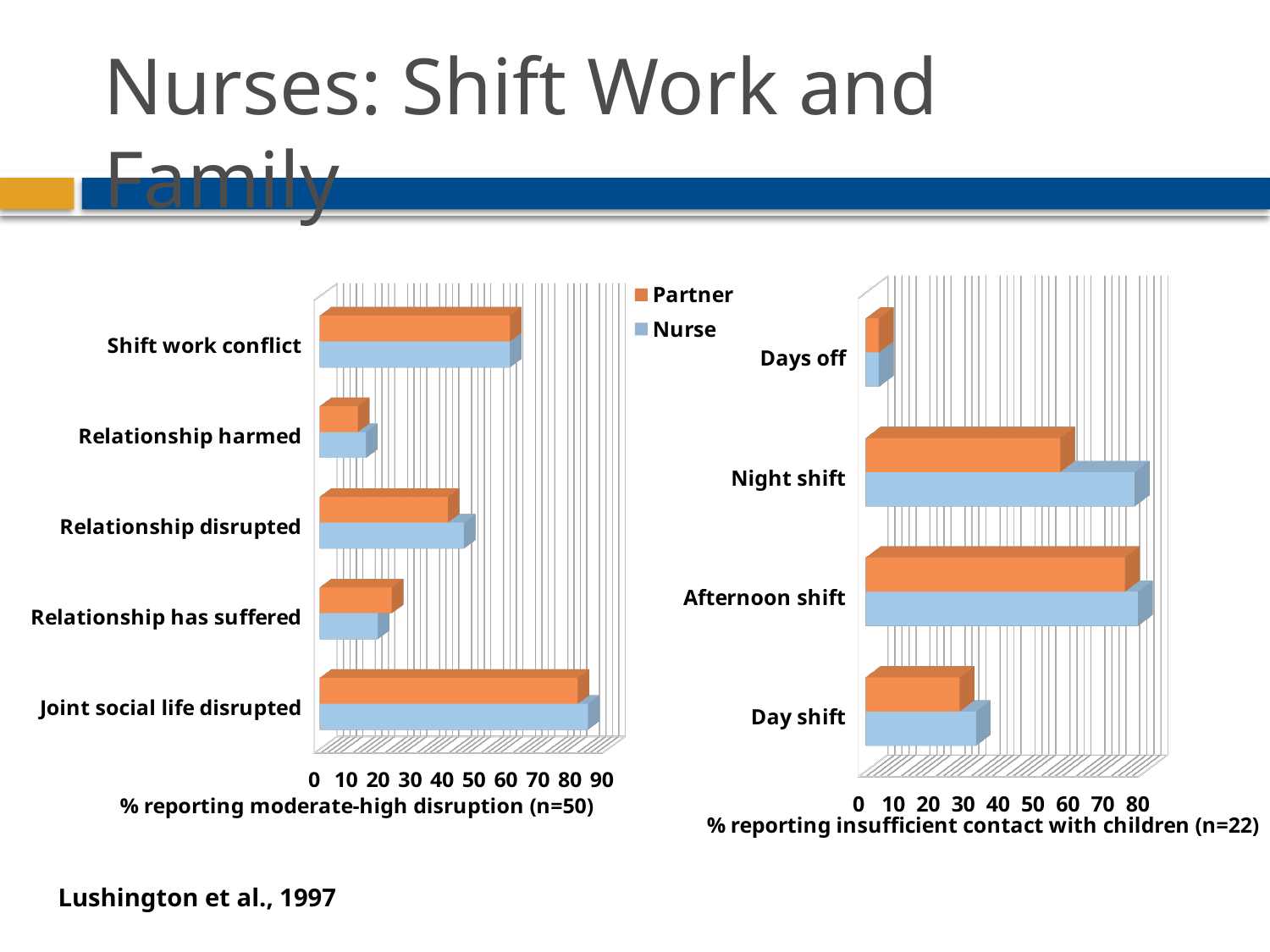
How many categories are shown in the chart titled '% reporting insufficient contact with children (n=22)'? 4 How many series does the legend list for the charts on the slide? 2 In the chart titled '% reporting moderate-high disruption (n=50)', is the Nurse value for Relationship harmed greater or less than 30? less What kind of chart is the chart titled '% reporting moderate-high disruption (n=50)'? bar chart In the chart titled '% reporting insufficient contact with children (n=22)', is the Partner value for Afternoon shift greater or less than 60? greater How many categories are shown in the chart titled '% reporting moderate-high disruption (n=50)'? 5 In the chart titled '% reporting moderate-high disruption (n=50)', is the Partner value for Shift work conflict greater or less than 50? greater In the chart titled '% reporting insufficient contact with children (n=22)', for Night shift, which series has the larger value, Partner or Nurse? Nurse In the chart titled '% reporting moderate-high disruption (n=50)', which category has the lowest Partner value? Relationship harmed In the chart titled '% reporting insufficient contact with children (n=22)', which category has the lowest Nurse value? Days off In the chart titled '% reporting moderate-high disruption (n=50)', which category has the highest Nurse value? Joint social life disrupted